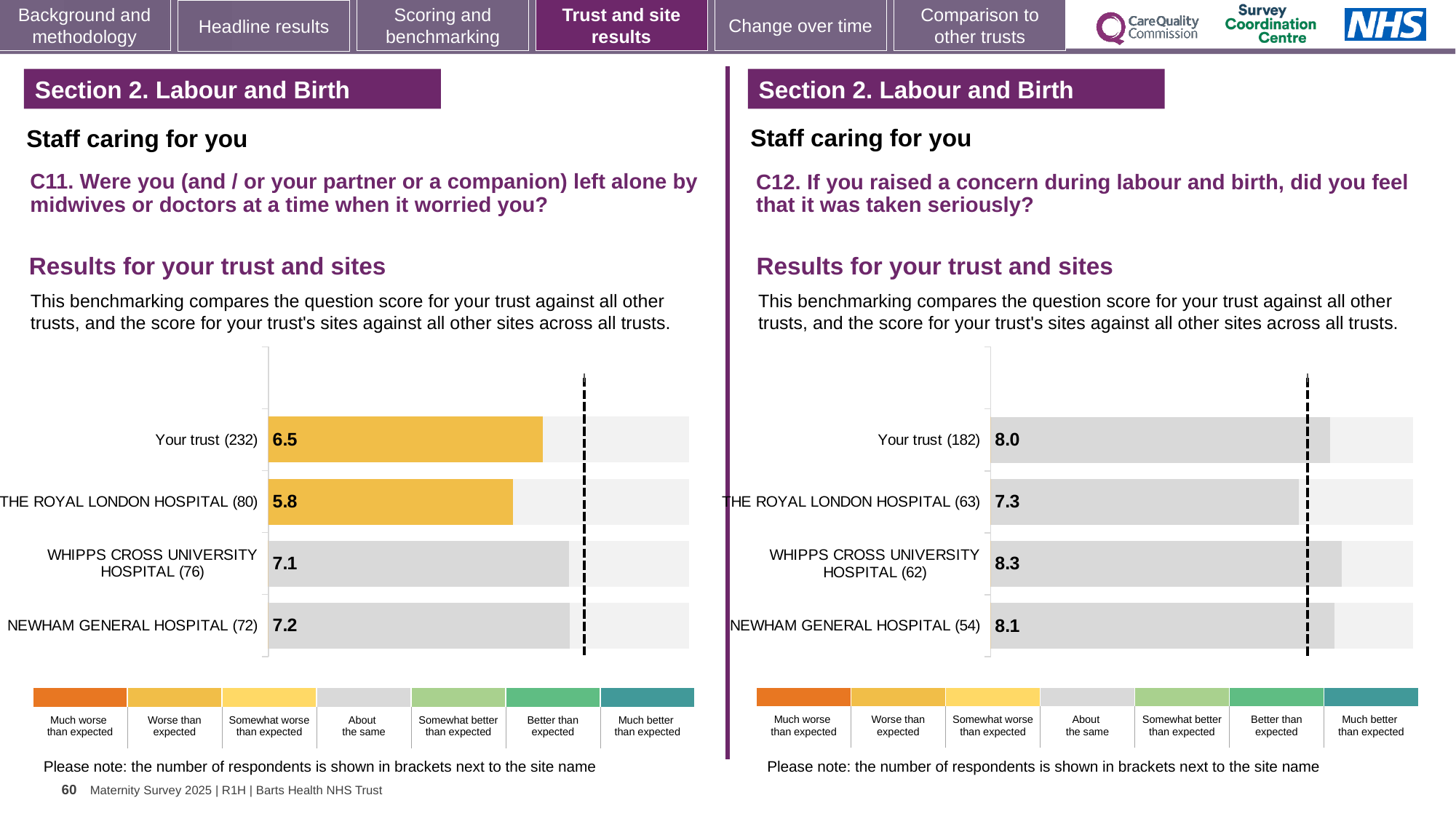
How many bars are shown in the C12 chart on the right? 4 In the C12 chart on the right, which site or trust has the highest score? WHIPPS CROSS UNIVERSITY HOSPITAL In the C12 chart on the right, what is the score for NEWHAM GENERAL HOSPITAL? 8.1 In the C12 chart on the right, what is the score for WHIPPS CROSS UNIVERSITY HOSPITAL? 8.3 In the C11 chart on the left, which has the higher score, Your trust or WHIPPS CROSS UNIVERSITY HOSPITAL? WHIPPS CROSS UNIVERSITY HOSPITAL In the C11 chart on the left, which site or trust has the lowest score? THE ROYAL LONDON HOSPITAL In the C11 chart on the left, what is the score for Your trust? 6.5 In the C11 chart on the left, what is the score for THE ROYAL LONDON HOSPITAL? 5.8 In the C11 chart on the left, how many respondents are shown in brackets for Your trust? 232 What type of chart is used in the C11 chart on the left? Bar chart In the C12 chart on the right, what is the difference between the scores for Your trust and THE ROYAL LONDON HOSPITAL? 0.7 In the C11 chart on the left, what is the difference between the scores for NEWHAM GENERAL HOSPITAL and THE ROYAL LONDON HOSPITAL? 1.4